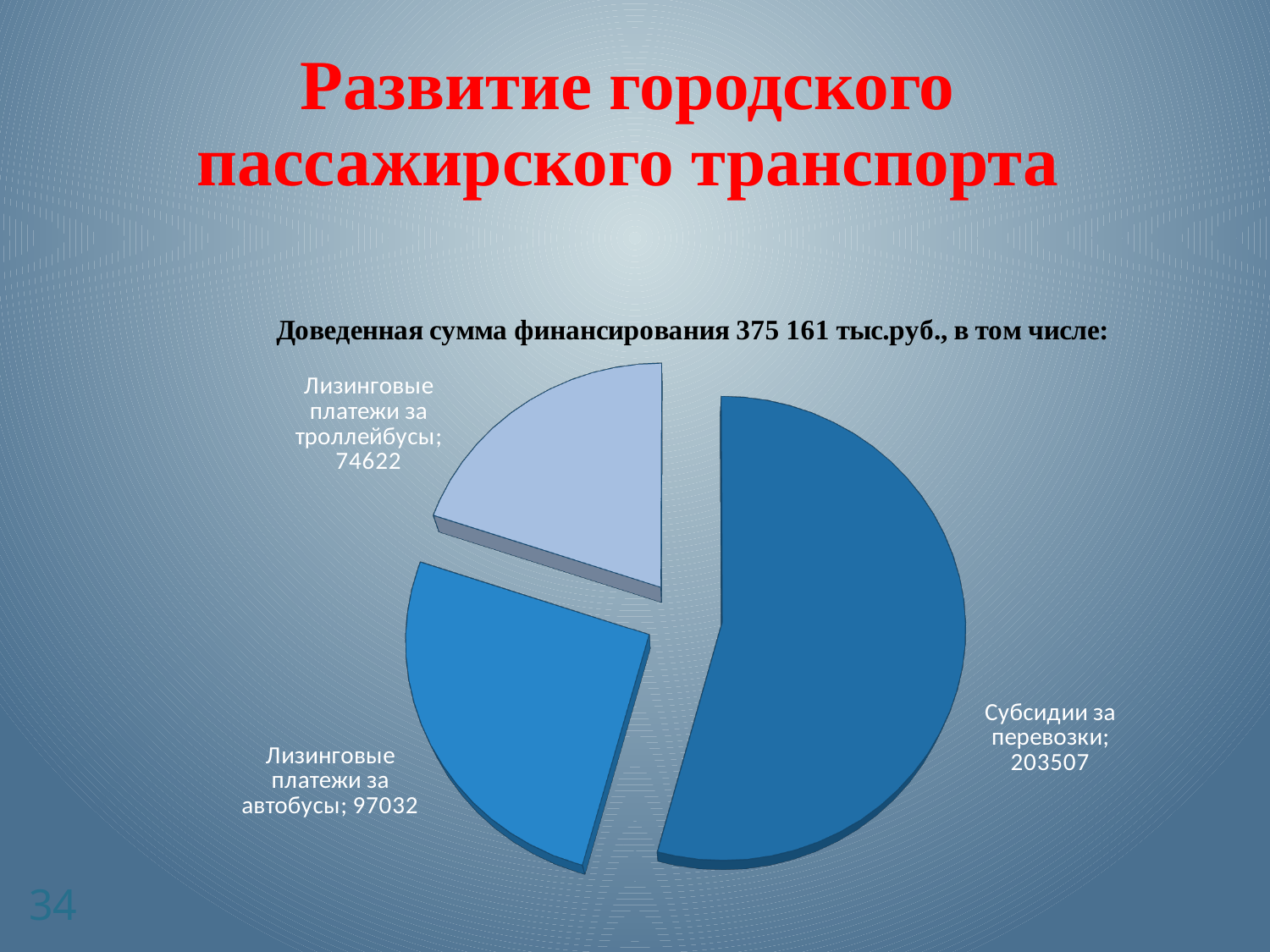
What is the difference between the values for Субсидии за перевозки and Лизинговые платежи за автобусы? 106475 What type of chart is shown on the slide? pie chart What is the difference between the values for Лизинговые платежи за автобусы and Лизинговые платежи за троллейбусы? 22410 What is the value for Субсидии за перевозки? 203507 Which category has the largest slice of the pie? Субсидии за перевозки What total funding amount is stated in the text above the pie chart? 375 161 тыс.руб. What is the total of all three slices of the pie chart? 375161 What is the value for Лизинговые платежи за автобусы? 97032 Which category has the smallest slice of the pie? Лизинговые платежи за троллейбусы Which is larger: Лизинговые платежи за автобусы or Лизинговые платежи за троллейбусы? Лизинговые платежи за автобусы How many slices does the pie chart have? 3 What is the value for Лизинговые платежи за троллейбусы? 74622